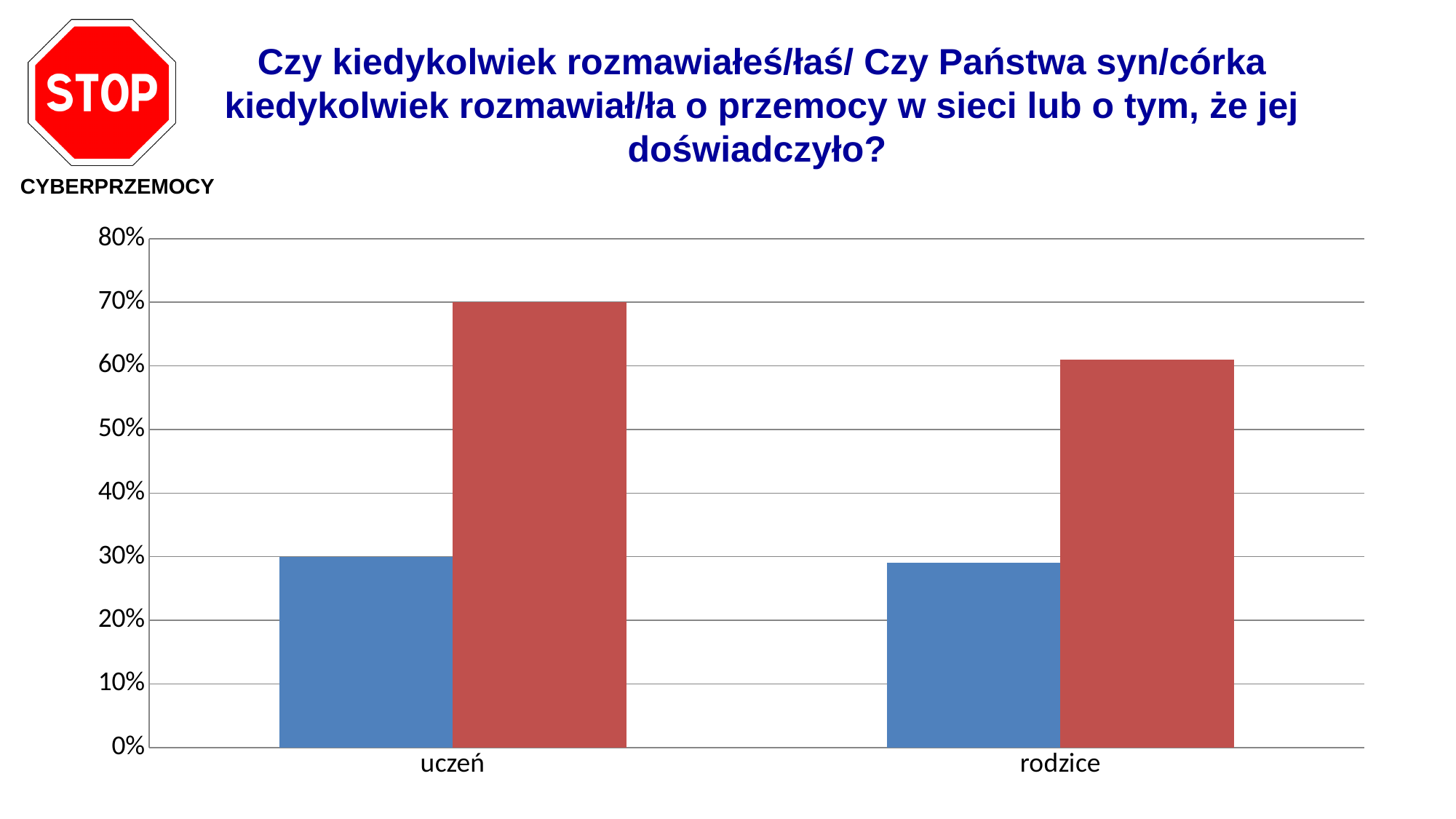
Which red bar is taller, the one for uczeń or the one for rodzice? uczeń For rodzice, which bar is larger, the red one or the blue one? the red one What is the value of the blue bar for uczeń? 30% What are the two categories on the x axis of the chart? uczeń and rodzice What kind of chart is shown on the slide? bar chart Is the value of the blue bar for rodzice greater or less than 40%? less Is the value of the red bar for rodzice greater or less than 50%? greater Which bar is the tallest in the chart? the red bar for uczeń What is the difference between the red bar and the blue bar for uczeń? 40% What is the highest value shown on the y axis of the chart? 80% How many categories are shown on the x axis of the chart? 2 What is the value of the red bar for uczeń? 70%